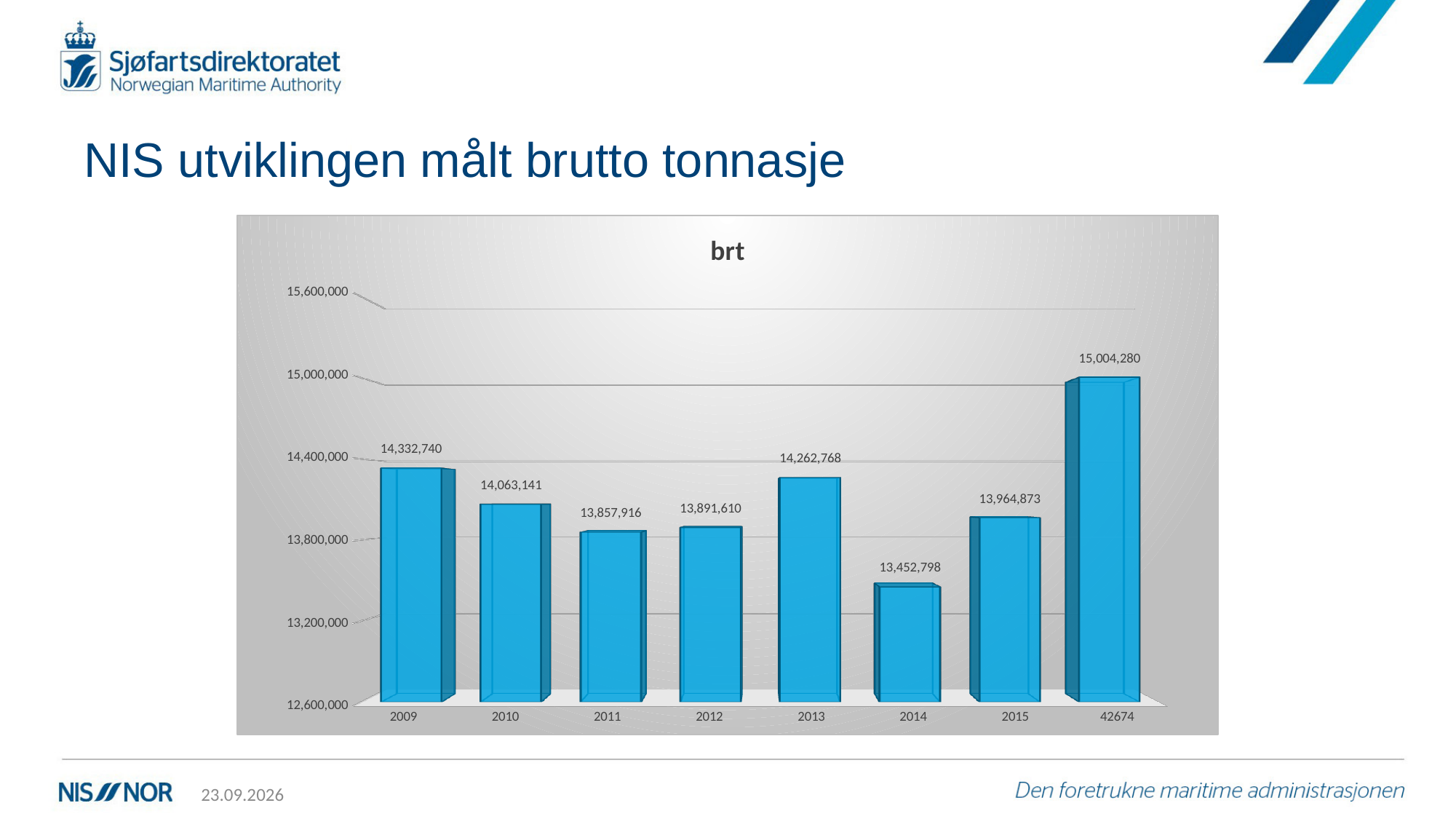
How many bars are shown in the chart? 8 What is the value for 2015? 13,964,873 What is the value for 2014? 13,452,798 Is the value for 2014 greater or less than 13,800,000? less What is the value for 2013? 14,262,768 Which year has the lowest value? 2014 Which is larger, the value for 2013 or the value for 2015? 2013 What is the difference between the values for 2009 and 2010? 269,599 What is the title of the chart? brt What is the difference between the value for 42674 and the value for 2014? 1,551,482 What is the value for 2009? 14,332,740 Which category has the highest value? 42674